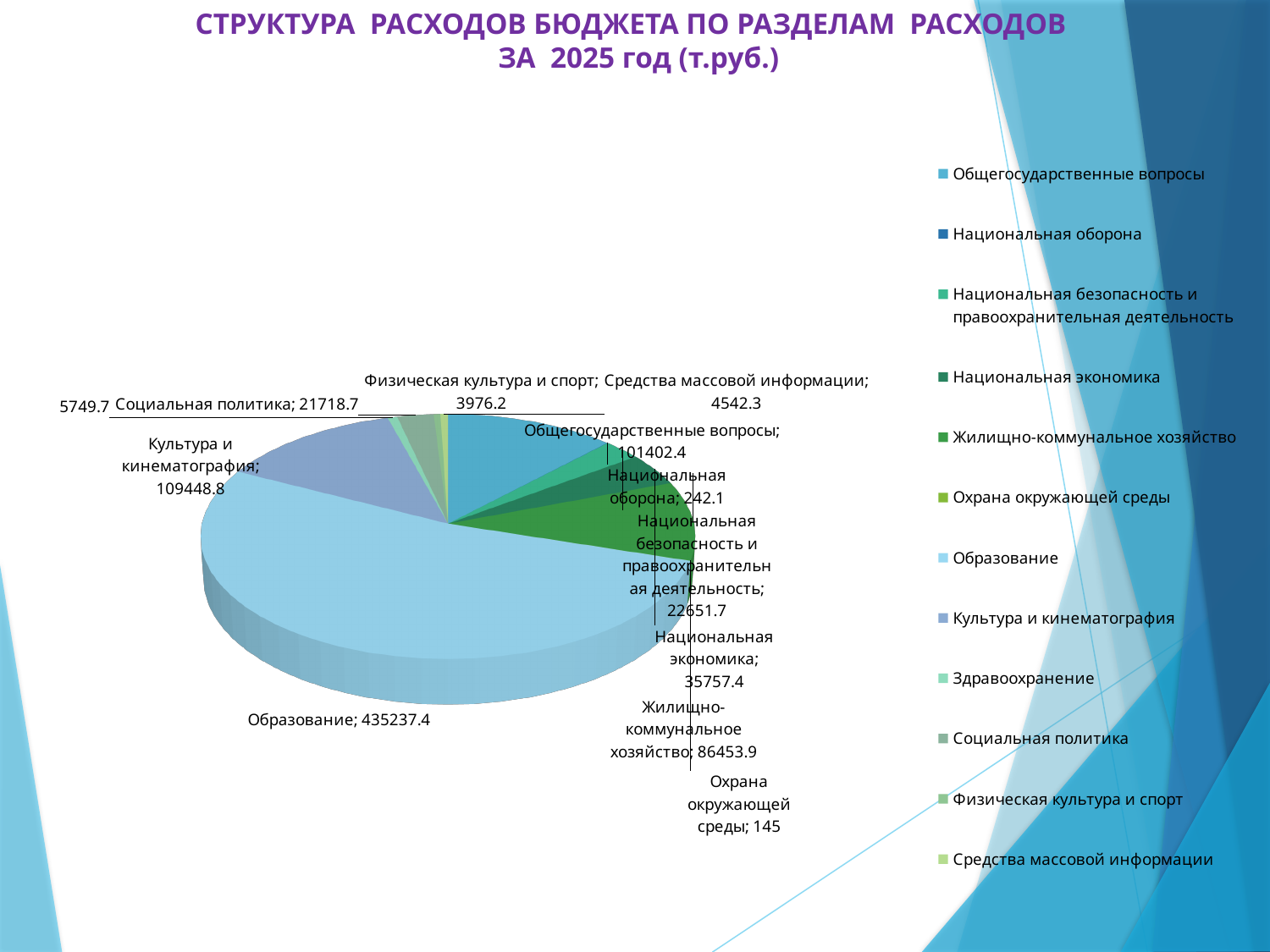
What is the value for Общегосударственные вопросы? 101402.4 What is the value for Жилищно-коммунальное хозяйство? 86453.9 What is the value for Образование? 435237.4 What kind of chart is shown on the slide? pie chart Which is larger, the value for Социальная политика or the value for Средства массовой информации? Социальная политика Which category has the smallest value shown on the chart? Охрана окружающей среды What is the value for Культура и кинематография? 109448.8 What is the difference between the values for Национальная экономика and Национальная безопасность и правоохранительная деятельность? 13105.7 Which category has the largest share of the pie? Образование What is the value for Охрана окружающей среды? 145 What year does the chart title refer to? 2025 How many entries does the legend list? 12